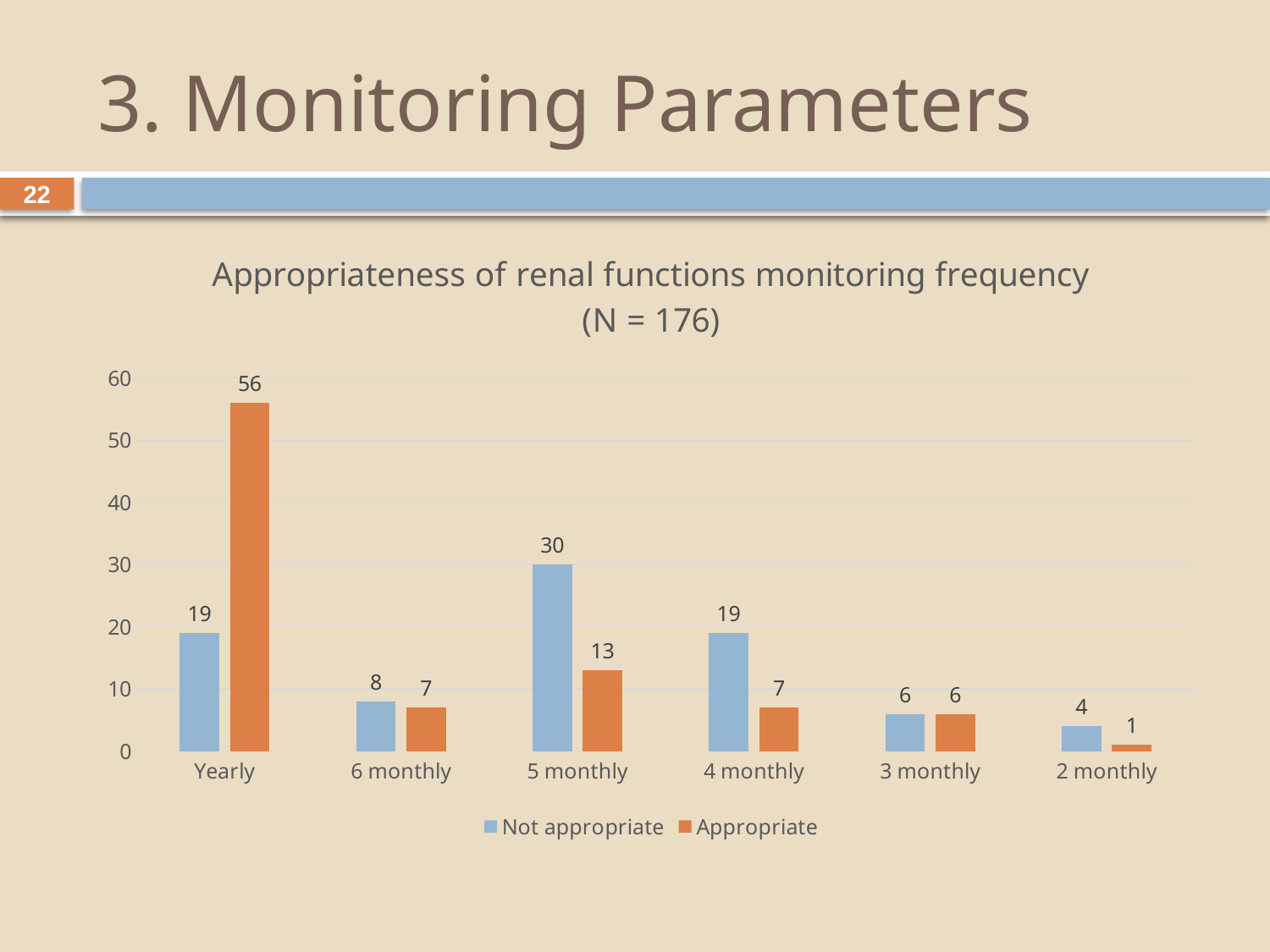
What is the title of the chart? Appropriateness of renal functions monitoring frequency (N = 176) Which category has the lowest Appropriate value? 2 monthly What kind of chart is shown on the slide? Bar chart Which is larger in the 4 monthly category, Not appropriate or Appropriate? Not appropriate Which category has the highest Not appropriate value? 5 monthly What is the difference between the Appropriate and Not appropriate values for Yearly? 37 What is the value for Appropriate in the Yearly category? 56 How many series does the legend list? 2 What is the value for Appropriate in the 2 monthly category? 1 How many categories are shown on the x axis? 6 What is the value for Not appropriate in the 5 monthly category? 30 What colour are the Appropriate bars? Orange